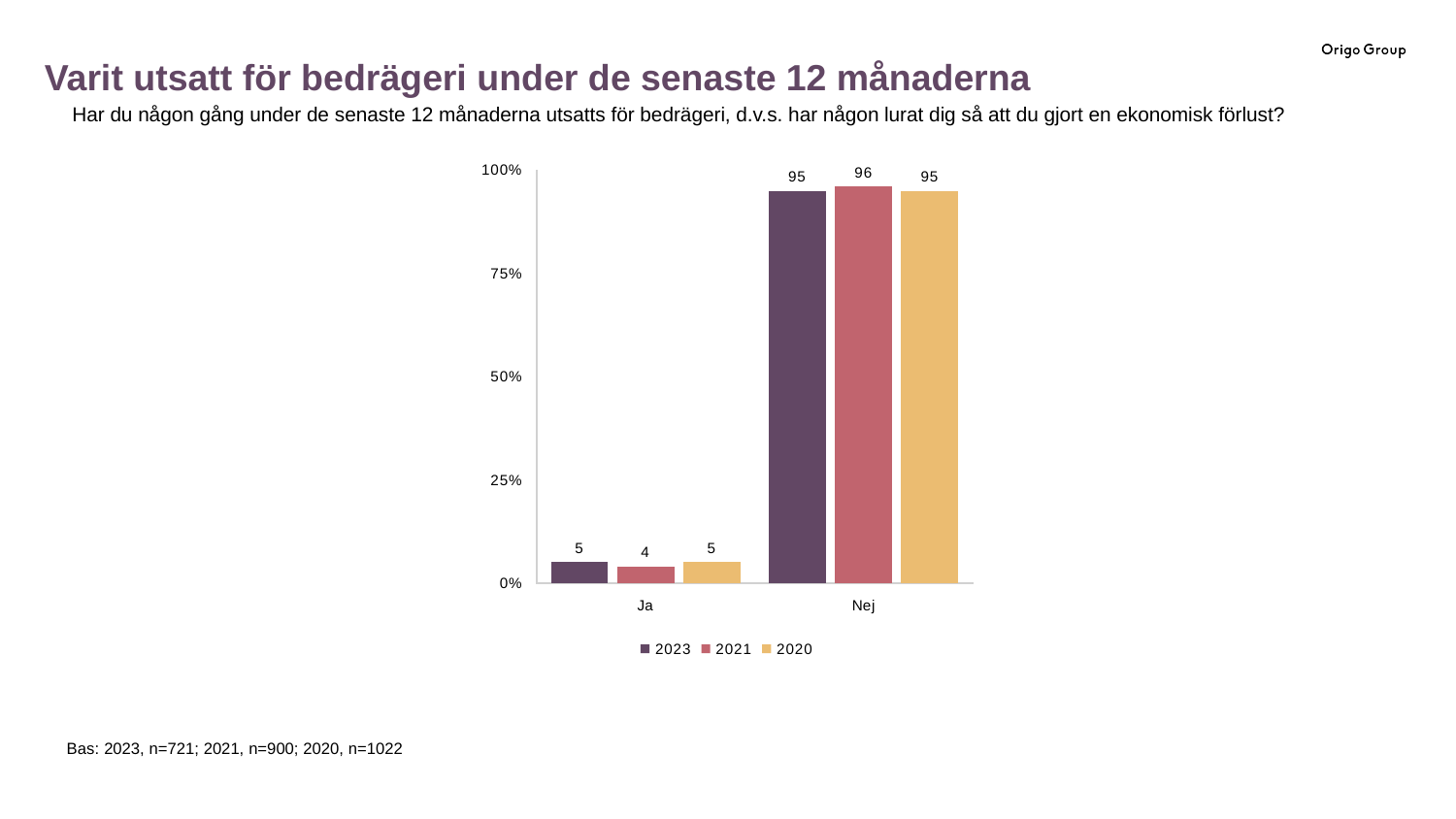
Is the value for 'Nej' in the 2023 series greater or less than 75%? greater What is the value for 'Nej' in the 2021 series? 96 What is the value for 'Nej' in the 2020 series? 95 Which is larger: the 2023 value for 'Ja' or the 2021 value for 'Ja'? 2023 What kind of chart is shown on the slide? bar chart How many categories are shown on the x axis? 2 What is the value for 'Ja' in the 2023 series? 5 What is the value for 'Ja' in the 2021 series? 4 Which series has the lowest value for 'Ja'? 2021 What is the difference between the 'Nej' and 'Ja' values in the 2023 series? 90 How many series does the legend list? 3 Which series has the highest value for 'Nej'? 2021